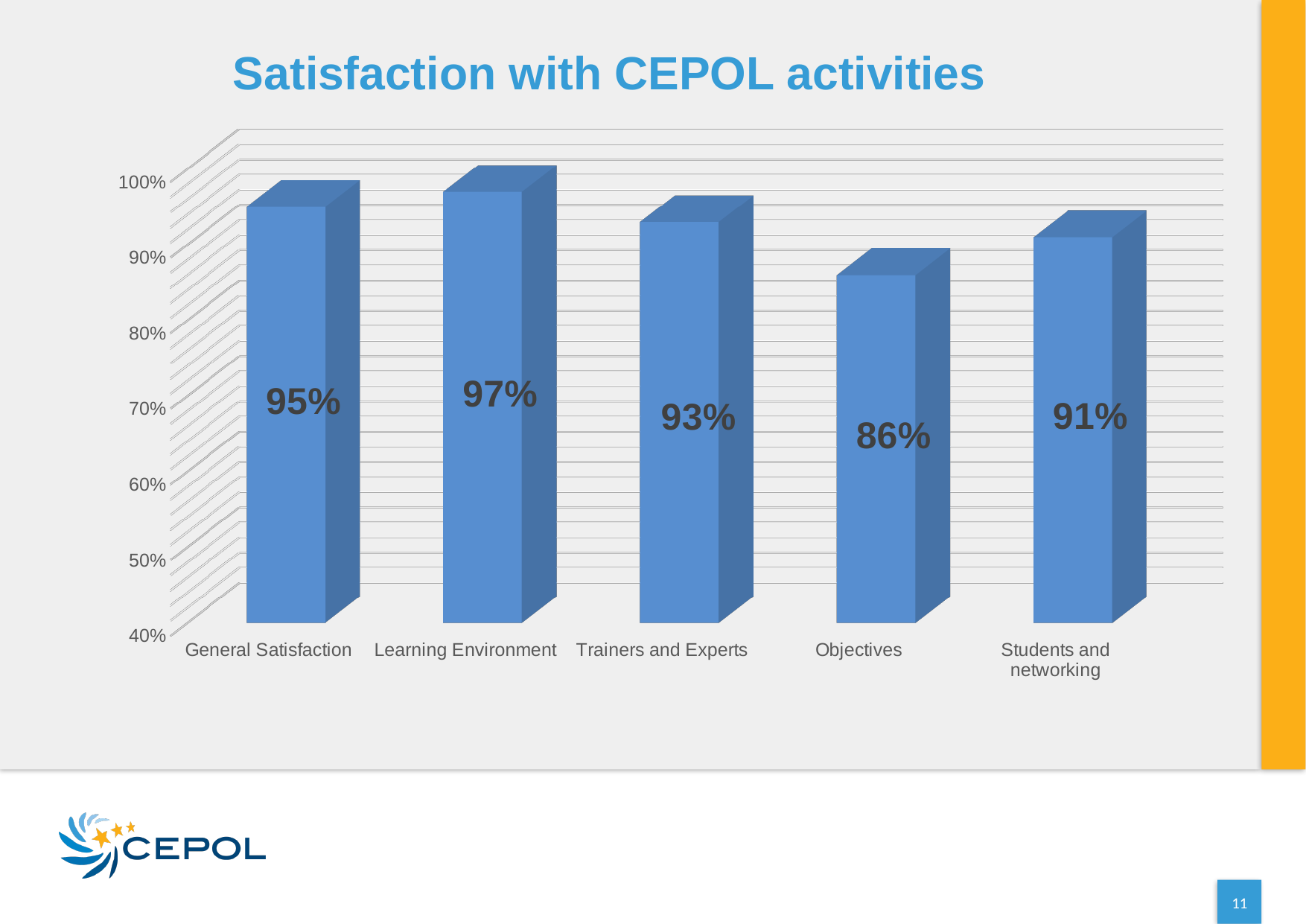
What is the difference between the values for General Satisfaction and Objectives? 9% Which category has the lowest satisfaction value? Objectives What is the satisfaction value for Students and networking? 91% What is the satisfaction value for Learning Environment? 97% What is the difference between the values for Learning Environment and Trainers and Experts? 4% What is the satisfaction value for Objectives? 86% What kind of chart is shown on the slide? bar chart Which is larger, the value for Trainers and Experts or the value for Students and networking? Trainers and Experts How many categories are shown in the chart? 5 Is the value for Objectives greater or less than 90%? less Which category has the highest satisfaction value? Learning Environment What is the title of the chart? Satisfaction with CEPOL activities